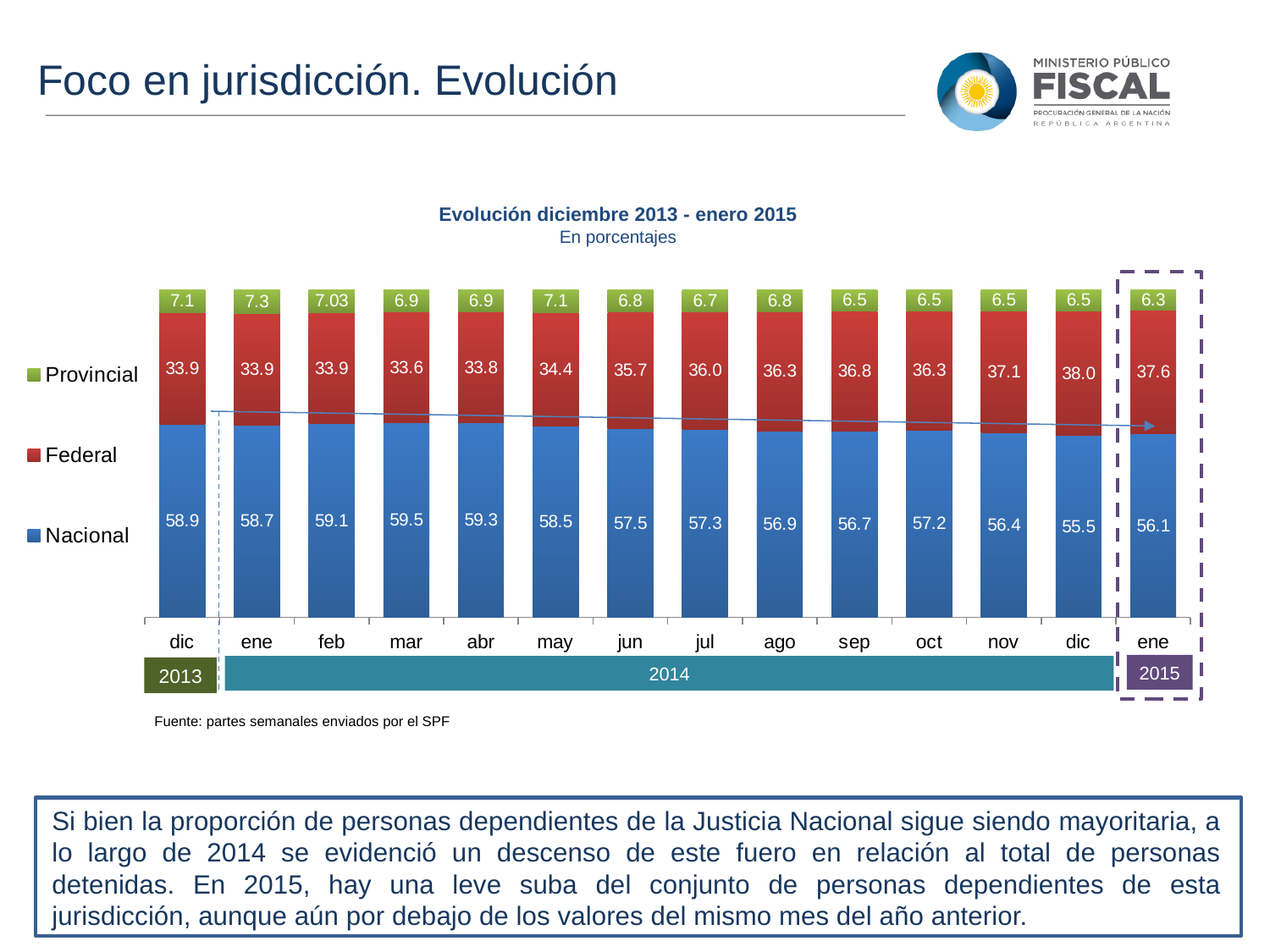
Does the Federal value rise or fall from dic 2013 to dic 2014? Rise Which is larger, the Nacional value for dic 2013 or for ene 2015? dic 2013 How many series does the legend list? 3 What is the Provincial value for feb 2014? 7.03 What kind of chart is shown on the slide? Stacked bar chart What is the total of the stacked bar for ene 2015? 100.0 What is the Nacional value for mar 2014? 59.5 What is the difference between the Nacional value in mar 2014 and in dic 2014? 4.0 How many months are plotted along the x axis? 14 What is the Federal value for ene 2015? 37.6 In which month is the Federal value highest? dic 2014 In which month is the Nacional value lowest? dic 2014